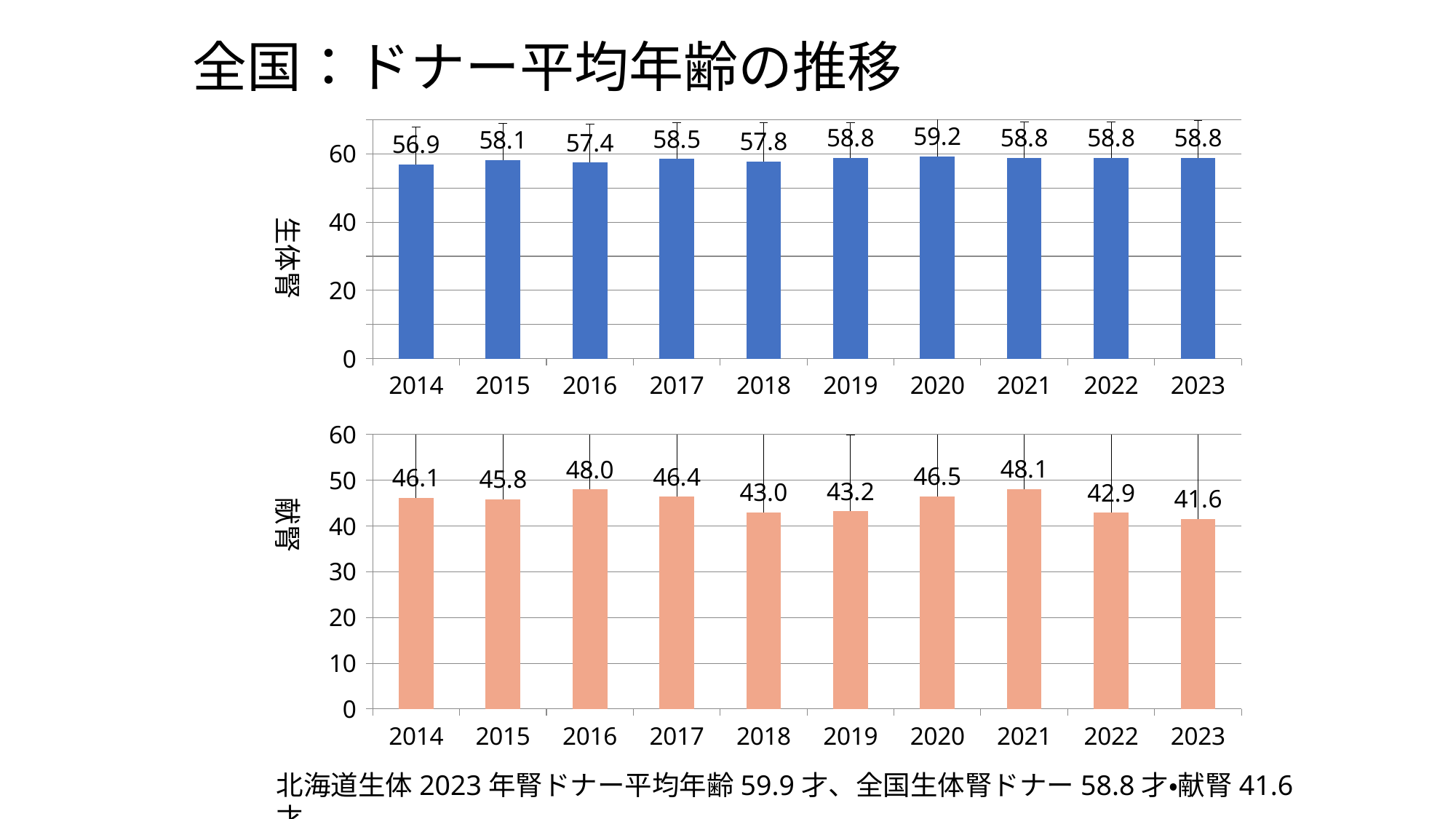
How many years are shown on the x axis of the top chart (生体腎)? 10 What is the title of the slide? 全国：ドナー平均年齢の推移 In the bottom chart (献腎), which year has the highest value? 2021 In the bottom chart (献腎), which year has the lowest value? 2023 In the bottom chart (献腎), what is the value for 2023? 41.6 In the top chart (生体腎), which year has the lowest value? 2014 In the bottom chart (献腎), what is the difference between the values for 2016 and 2018? 5.0 In the top chart (生体腎), what is the value for 2020? 59.2 In the top chart (生体腎), which year has the highest value? 2020 In the bottom chart (献腎), is the value for 2022 greater or less than 40? greater In the top chart (生体腎), which is larger, the value for 2015 or the value for 2016? 2015 What kind of chart is the bottom chart (献腎)? bar chart